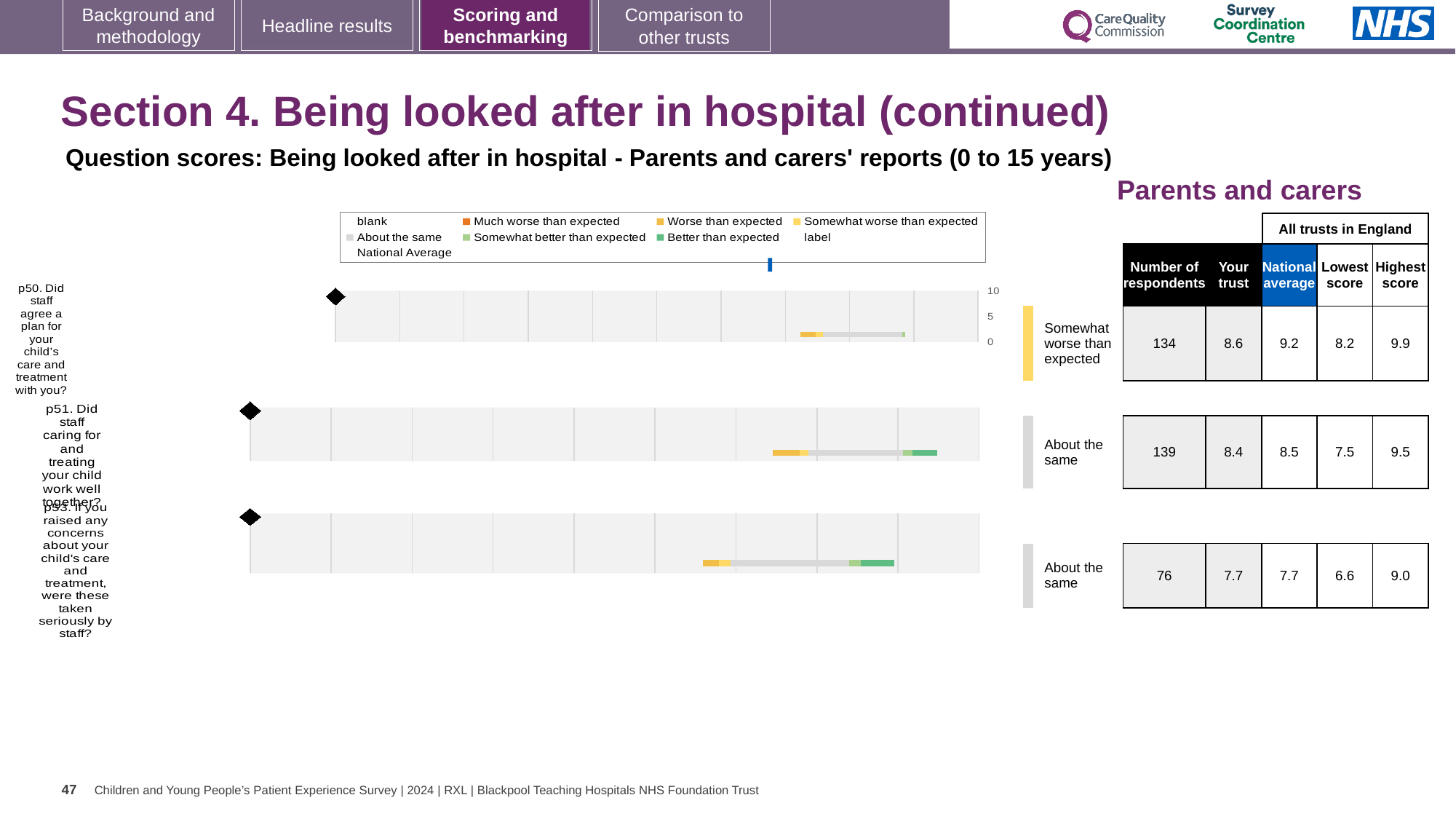
What benchmark category is shown for p50 (Did staff agree a plan for your child's care and treatment with you?)? Somewhat worse than expected What is the national average score for p53 (If you raised any concerns about your child's care and treatment, were these taken seriously by staff?)? 7.7 For p50, what is the difference between the highest score and the lowest score among all trusts in England? 1.7 What is the maximum value shown on the score axis of the charts? 10 Which question has the highest number of respondents? p51 What kind of chart is used to show the question scores on this slide? bar chart How many questions (p50, p51, p53) have a score chart on this slide? 3 What is the lowest score among all trusts in England for p51? 7.5 What is the 'Your trust' score for p50 (Did staff agree a plan for your child's care and treatment with you?)? 8.6 What is the number of respondents for p51 (Did staff caring for and treating your child work well together?)? 139 For p50, which is larger: the 'Your trust' score or the national average? National average What is the highest score among all trusts in England for p50? 9.9